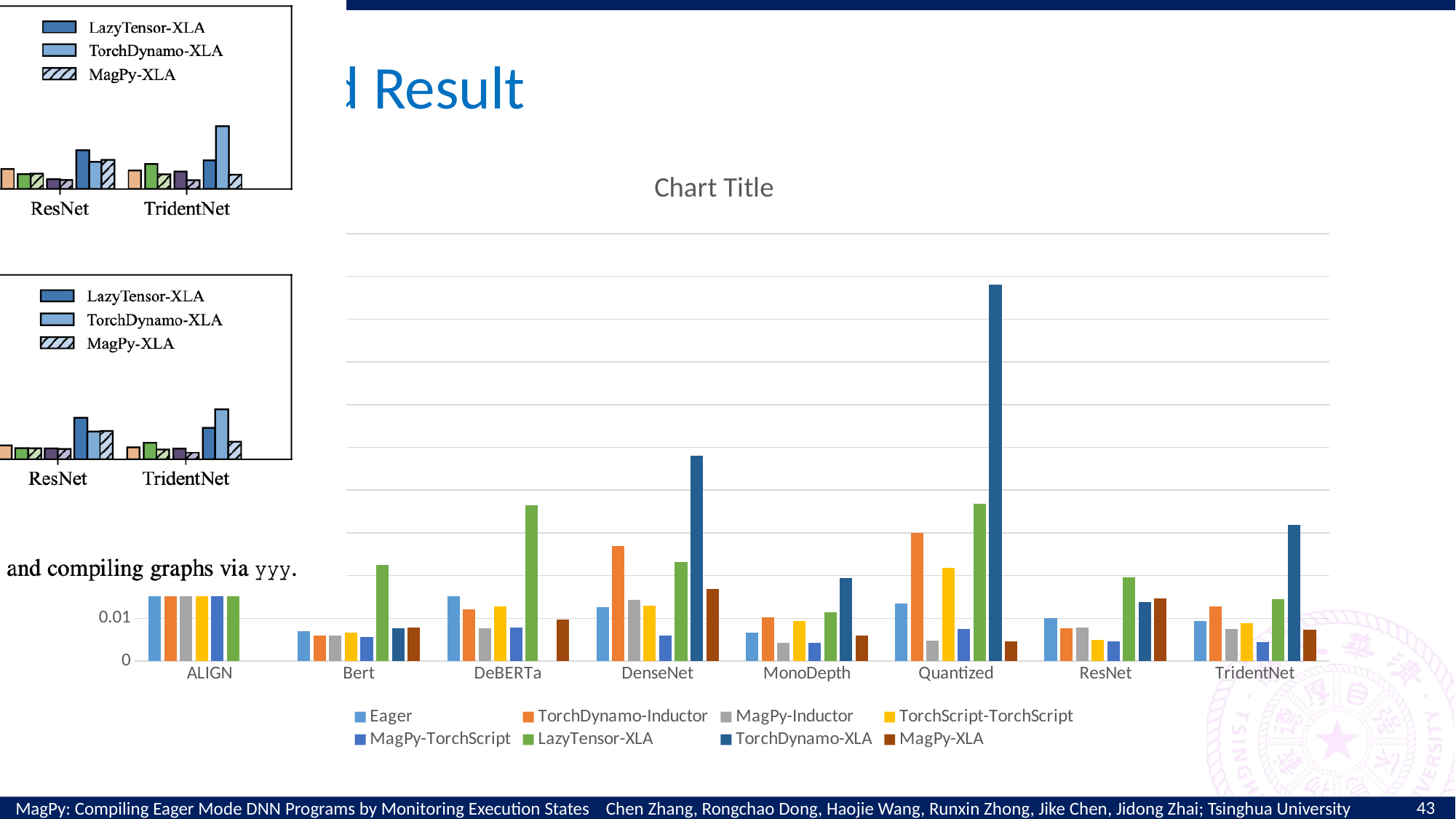
What is the title shown above the main chart on the slide? Chart Title In the main chart titled "Chart Title", is the LazyTensor-XLA value larger for DeBERTa or for Bert? DeBERTa In the main chart titled "Chart Title", which category contains the tallest bar overall? Quantized In the main chart titled "Chart Title", which series has the tallest bar in the Quantized category? TorchDynamo-XLA How many categories are shown on the x axis of the main chart titled "Chart Title"? 8 How many series does the legend of the main chart titled "Chart Title" list? 8 In the main chart titled "Chart Title", which series has the lowest bar in the DenseNet category? MagPy-TorchScript In the main chart titled "Chart Title", is the TorchDynamo-XLA value larger for Quantized or for DenseNet? Quantized In the main chart titled "Chart Title", is the Eager value for Bert greater or less than 0.01? less What kind of chart is the main chart titled "Chart Title"? bar chart In the main chart titled "Chart Title", is the MagPy-XLA value for MonoDepth greater or less than 0.01? less In the main chart titled "Chart Title", is the LazyTensor-XLA value for ResNet greater or less than 0.01? greater